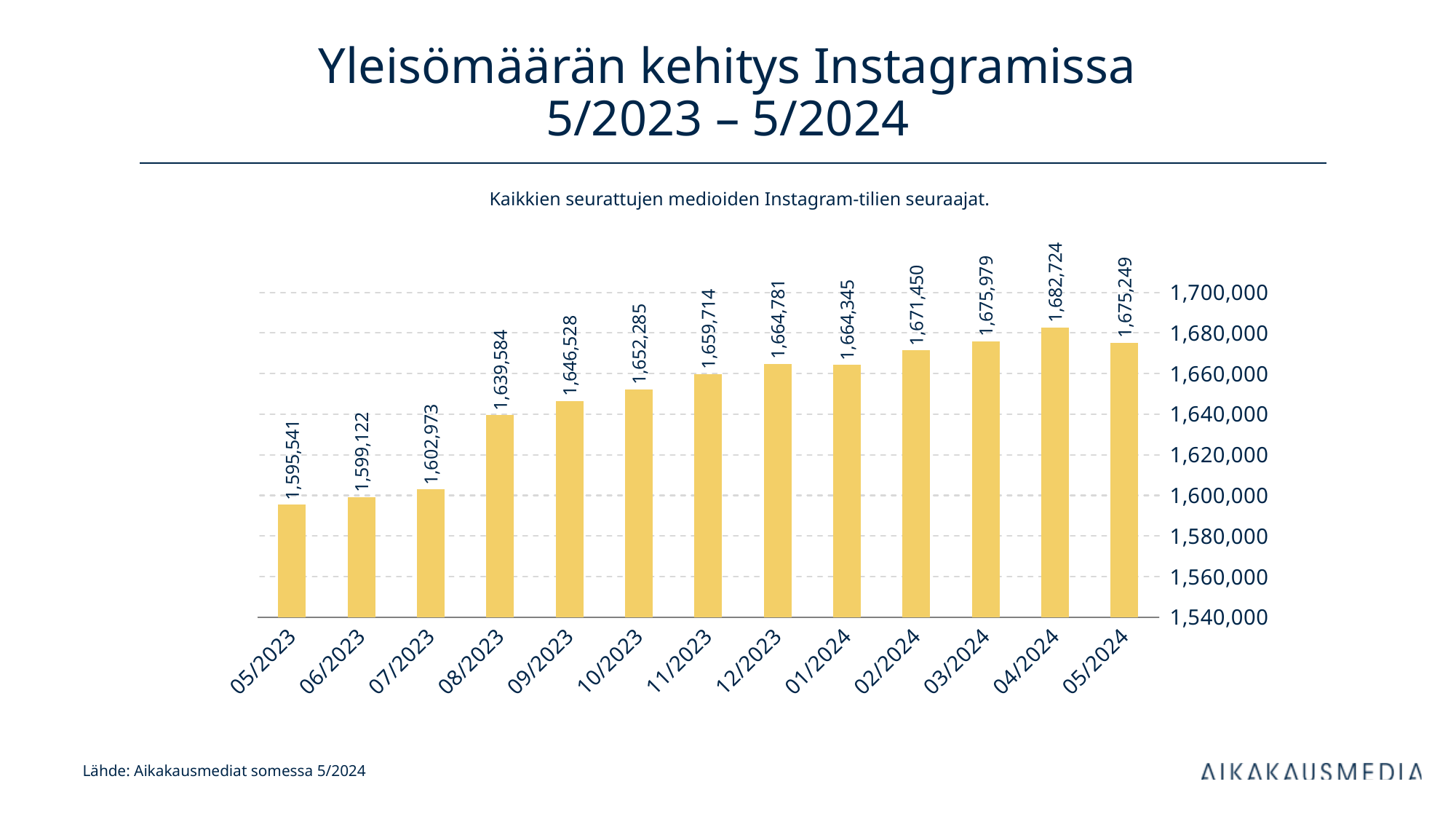
What is the title of the chart? Yleisömäärän kehitys Instagramissa 5/2023 – 5/2024 How many months are shown on the x axis? 13 Which is larger, the value for 03/2024 or the value for 05/2024? 03/2024 Is the value for 08/2023 greater or less than 1,620,000? greater Do the values generally rise or fall from 05/2023 to 04/2024? rise What is the difference between the values for 05/2024 and 05/2023? 79,708 Which month has the lowest value? 05/2023 What is the value for 12/2023? 1,664,781 What is the value for 05/2023? 1,595,541 Which month has the highest value? 04/2024 What kind of chart is shown on the slide? bar chart What is the value for 04/2024? 1,682,724